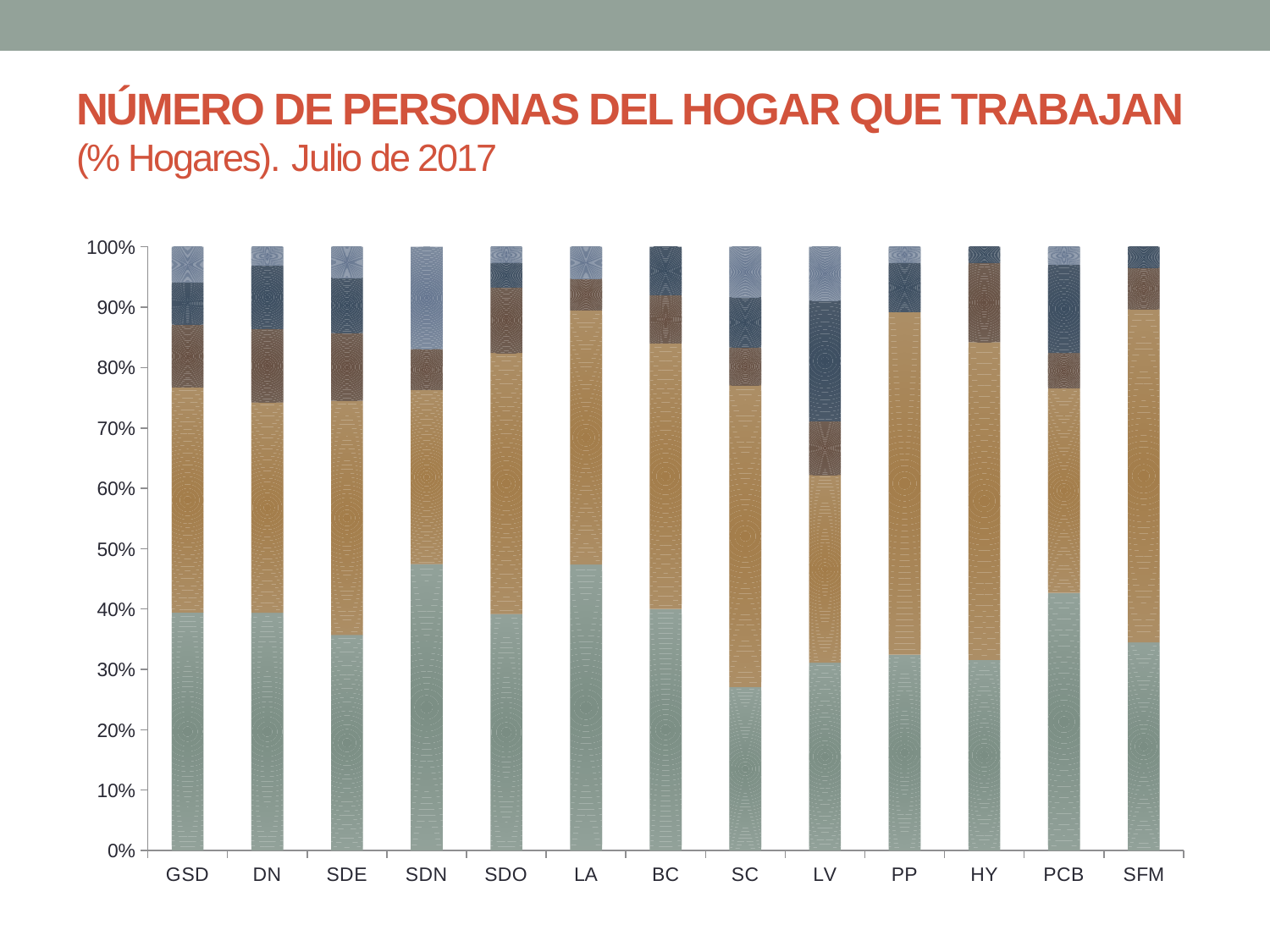
Is the bottom (green) segment for SFM greater or less than 30%? greater What is the total height of the stacked bar for GSD? 100% What is the label of the first category on the x axis? GSD How many categories are shown along the x axis of the chart? 13 Is the bottom (green) segment for SDN greater or less than 40%? greater What kind of chart is shown on the slide? Stacked bar chart Is the bottom (green) segment for SDE greater or less than 40%? less Which has the larger bottom (green) segment, PCB or PP? PCB What is the title of the chart on the slide? NÚMERO DE PERSONAS DEL HOGAR QUE TRABAJAN (% Hogares). Julio de 2017 Which has the larger bottom (green) segment, SDN or SC? SDN Which category has the smallest bottom (green) segment? SC